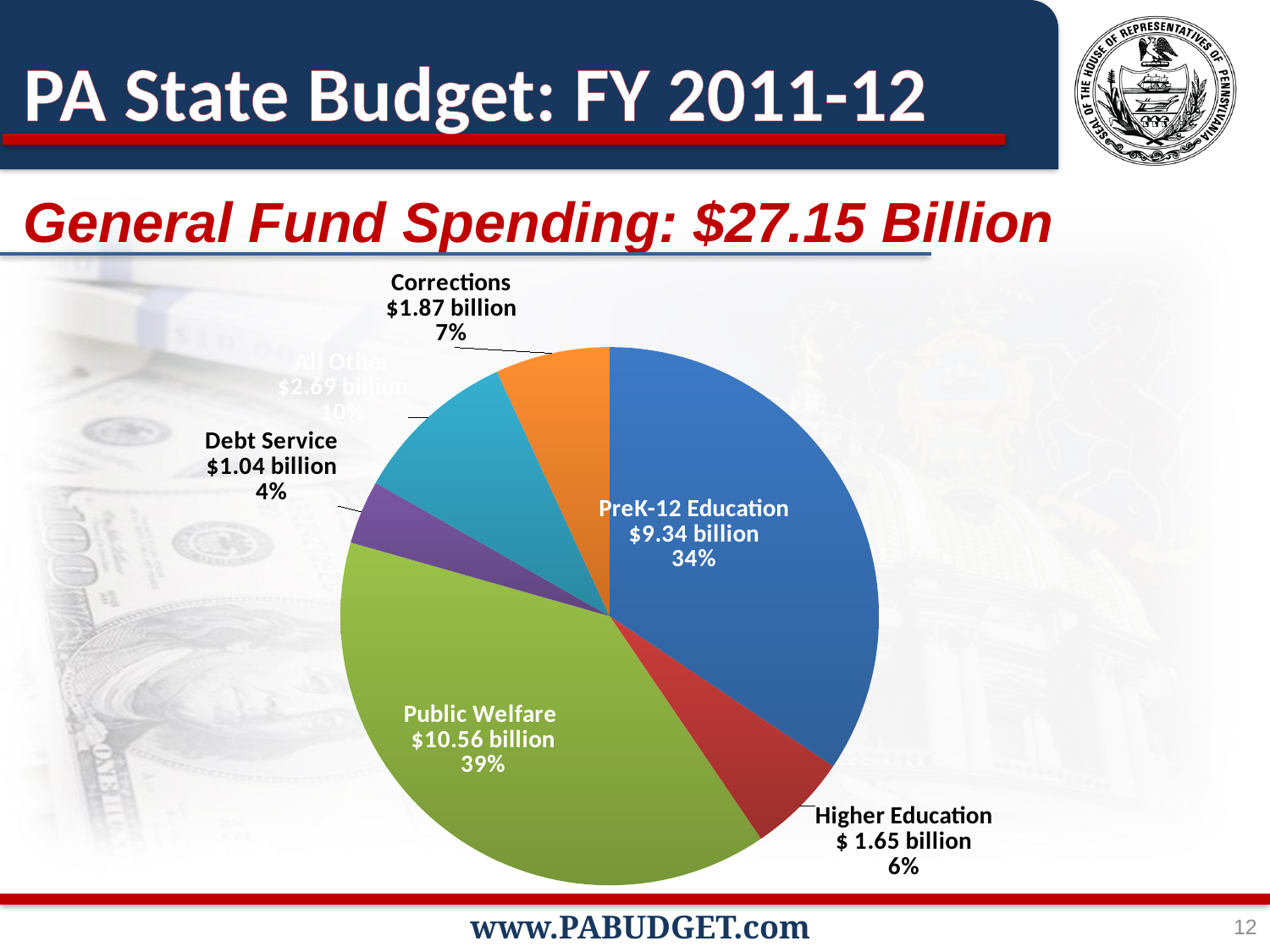
How many slices does the pie chart have? 6 What is the difference in percentage points between Public Welfare and PreK-12 Education? 5 percentage points What percentage share does Debt Service have? 4% What is the dollar amount shown for Public Welfare? $10.56 billion What is the dollar amount shown for Corrections? $1.87 billion What kind of chart is shown on the slide? pie chart What is the dollar amount shown for Higher Education? $ 1.65 billion Which category has the smallest slice of the pie? Debt Service Which is larger, Corrections or Higher Education? Corrections What percentage of the pie is PreK-12 Education? 34% Which category has the largest slice of the pie? Public Welfare What total General Fund Spending amount is stated in the heading above the chart? $27.15 Billion